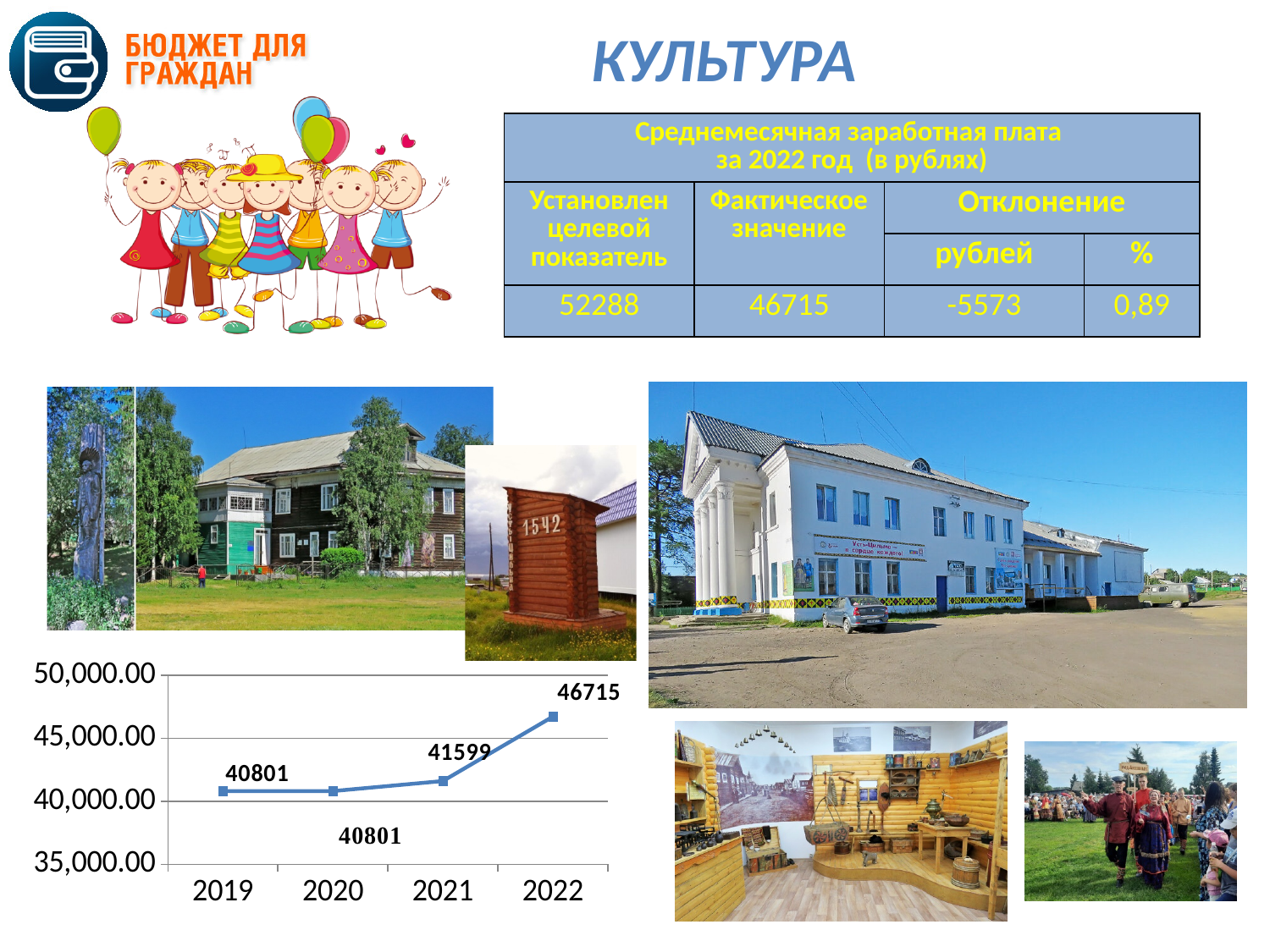
How many data points are plotted in the line chart? 4 Do the values in the line chart rise or fall from 2019 to 2022? rise Which is larger in the line chart, the value for 2021 or the value for 2022? 2022 What is the value plotted for 2019 in the line chart? 40801 What is the difference between the 2022 and 2021 values in the line chart? 5116 What kind of chart is shown at the bottom left of the slide? line chart What is the value plotted for 2021 in the line chart? 41599 What is the value plotted for 2022 in the line chart? 46715 What is the difference between the 2021 and 2020 values in the line chart? 798 Which year has the highest value in the line chart? 2022 Is the value for 2022 in the line chart greater or less than 45,000.00? greater What is the value plotted for 2020 in the line chart? 40801